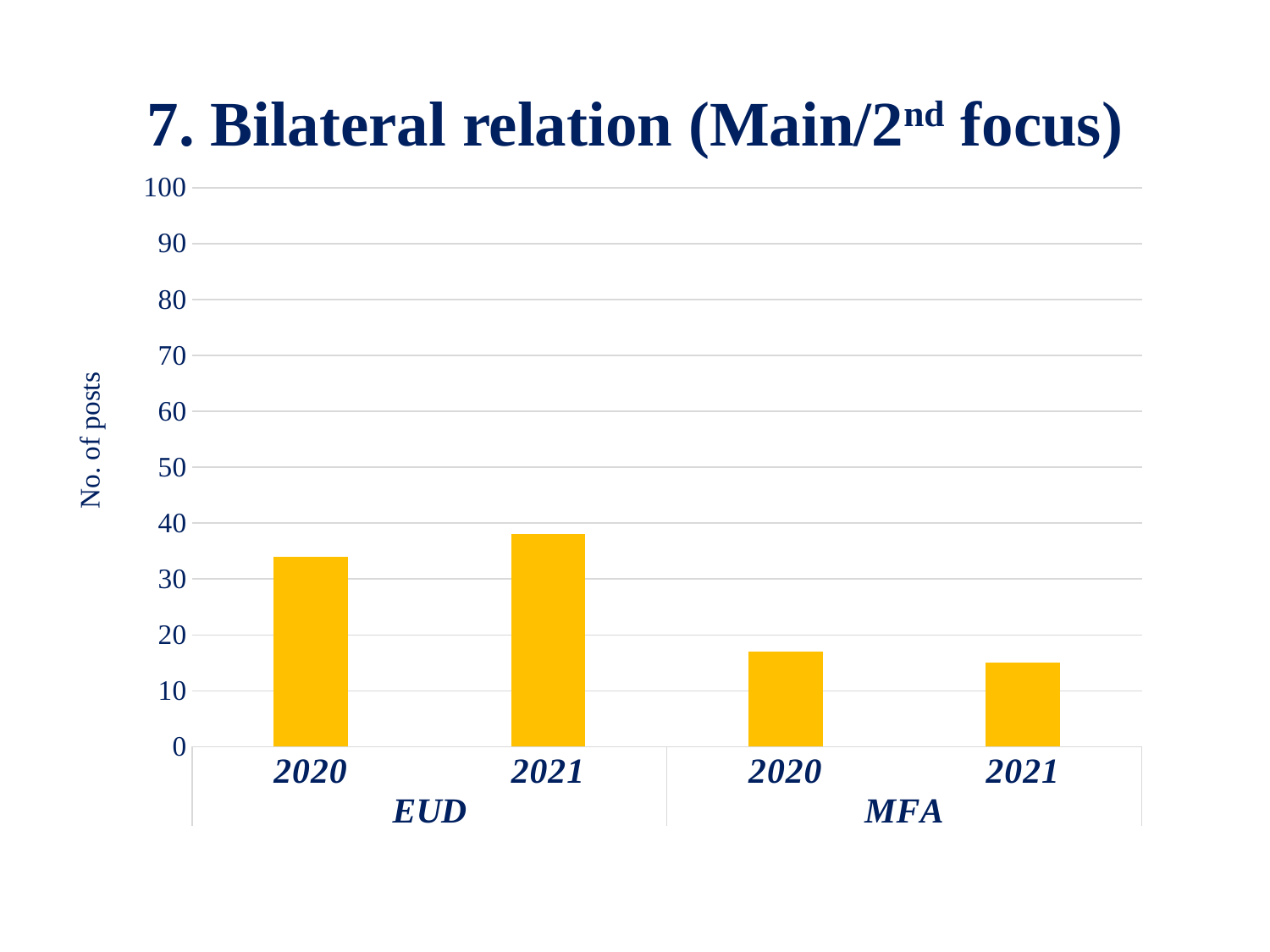
Is the value for EUD 2020 greater or less than 30? greater What is the label of the vertical axis? No. of posts What kind of chart is shown on the slide? bar chart Do the values for MFA rise or fall from 2020 to 2021? fall Is the value for EUD 2021 greater or less than 40? less Is the value for MFA 2021 greater or less than 10? greater Which is larger, the value for EUD 2020 or the value for MFA 2020? EUD 2020 What is the title of the chart? 7. Bilateral relation (Main/2nd focus) Which is larger, the value for EUD 2020 or the value for EUD 2021? EUD 2021 How many bars are plotted in the chart? 4 Which bar has the highest value in the chart? EUD 2021